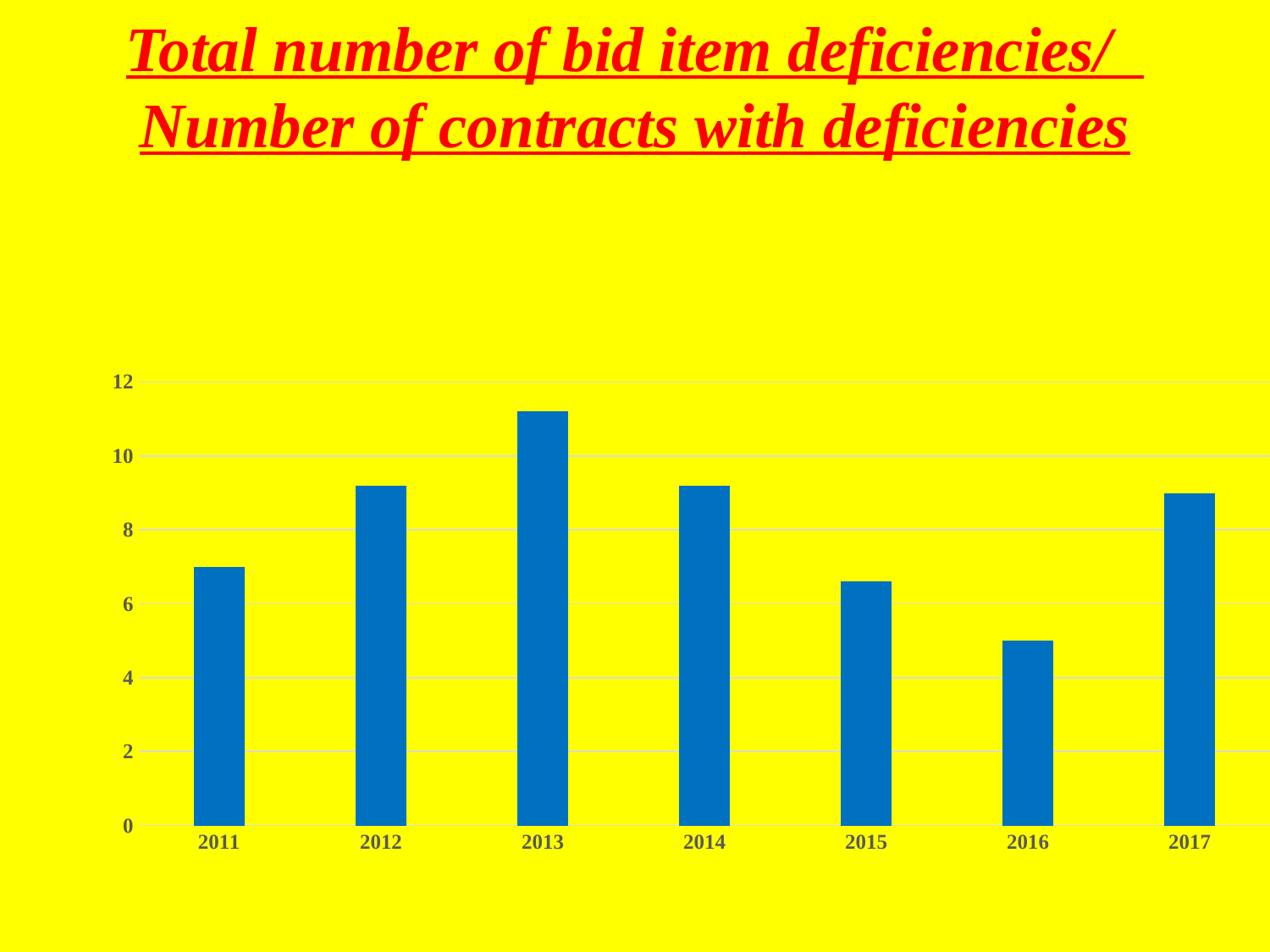
How many years are shown on the x axis of the chart? 7 Is the value for 2016 greater or less than 6? less Is the value for 2017 greater or less than 8? greater Is the value for 2012 greater or less than 10? less Which year has the lowest bar in the chart? 2016 What kind of chart is shown on the slide? bar chart Which year has the highest bar in the chart? 2013 Which is larger, the value for 2011 or the value for 2016? 2011 Do the values rise or fall from 2013 to 2016? fall Which is larger, the value for 2013 or the value for 2017? 2013